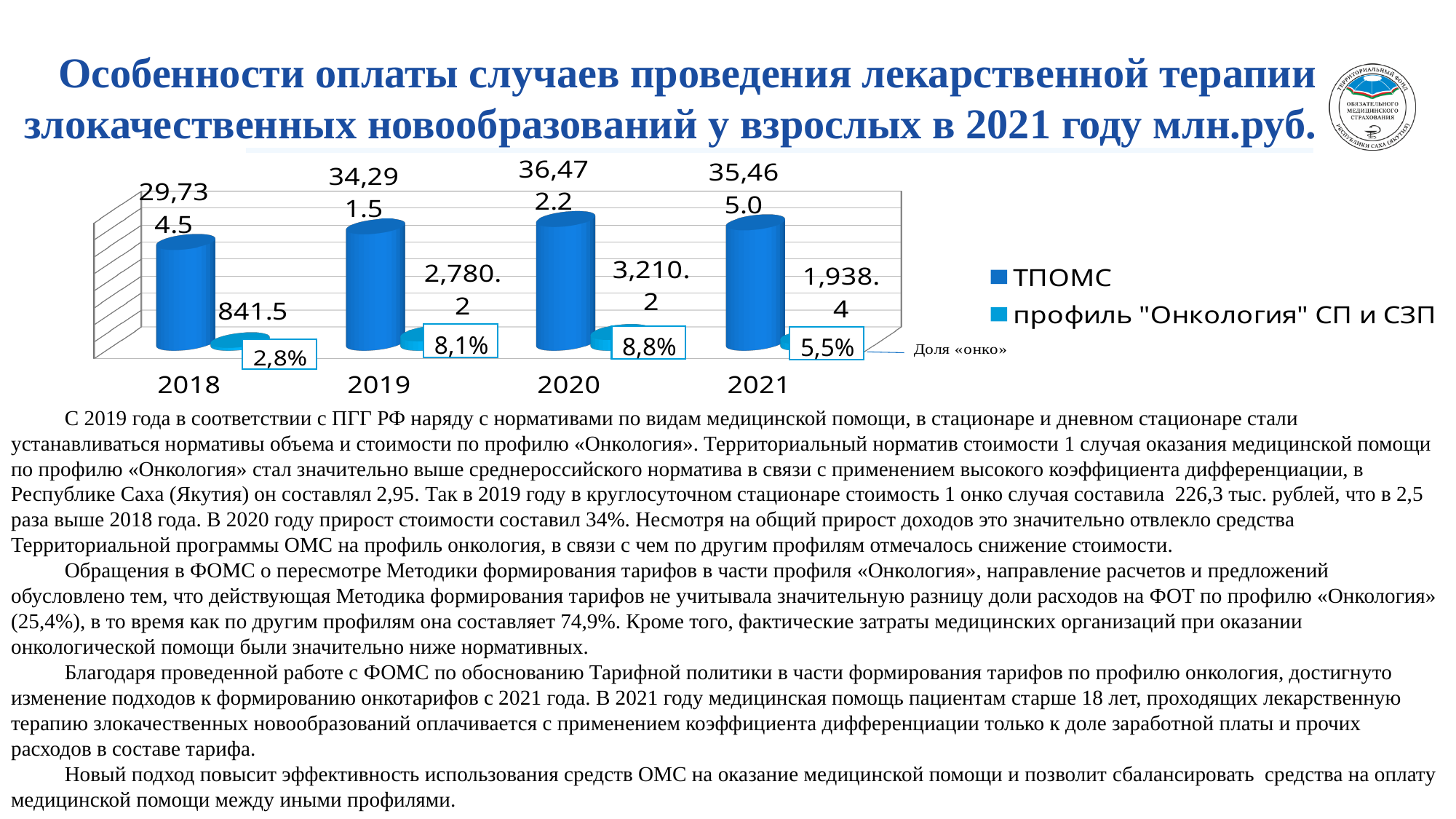
What is the difference between the профиль "Онкология" СП и СЗП values for 2020 and 2019? 430.0 What type of chart is shown on the slide? bar chart How many series does the chart legend list? 2 How many years are shown on the x axis of the chart? 4 Which is larger, the профиль "Онкология" СП и СЗП value for 2021 or for 2019? 2019 What is the "Доля «онко»" percentage shown for 2019? 8,1% What is the value for профиль "Онкология" СП и СЗП in 2021? 1,938.4 In which year is the ТПОМС value the highest? 2020 In which year is the профиль "Онкология" СП и СЗП value the lowest? 2018 What is the value for профиль "Онкология" СП и СЗП in 2018? 841.5 In which year is the ТПОМС value the lowest? 2018 What is the value for профиль "Онкология" СП и СЗП in 2020? 3,210.2